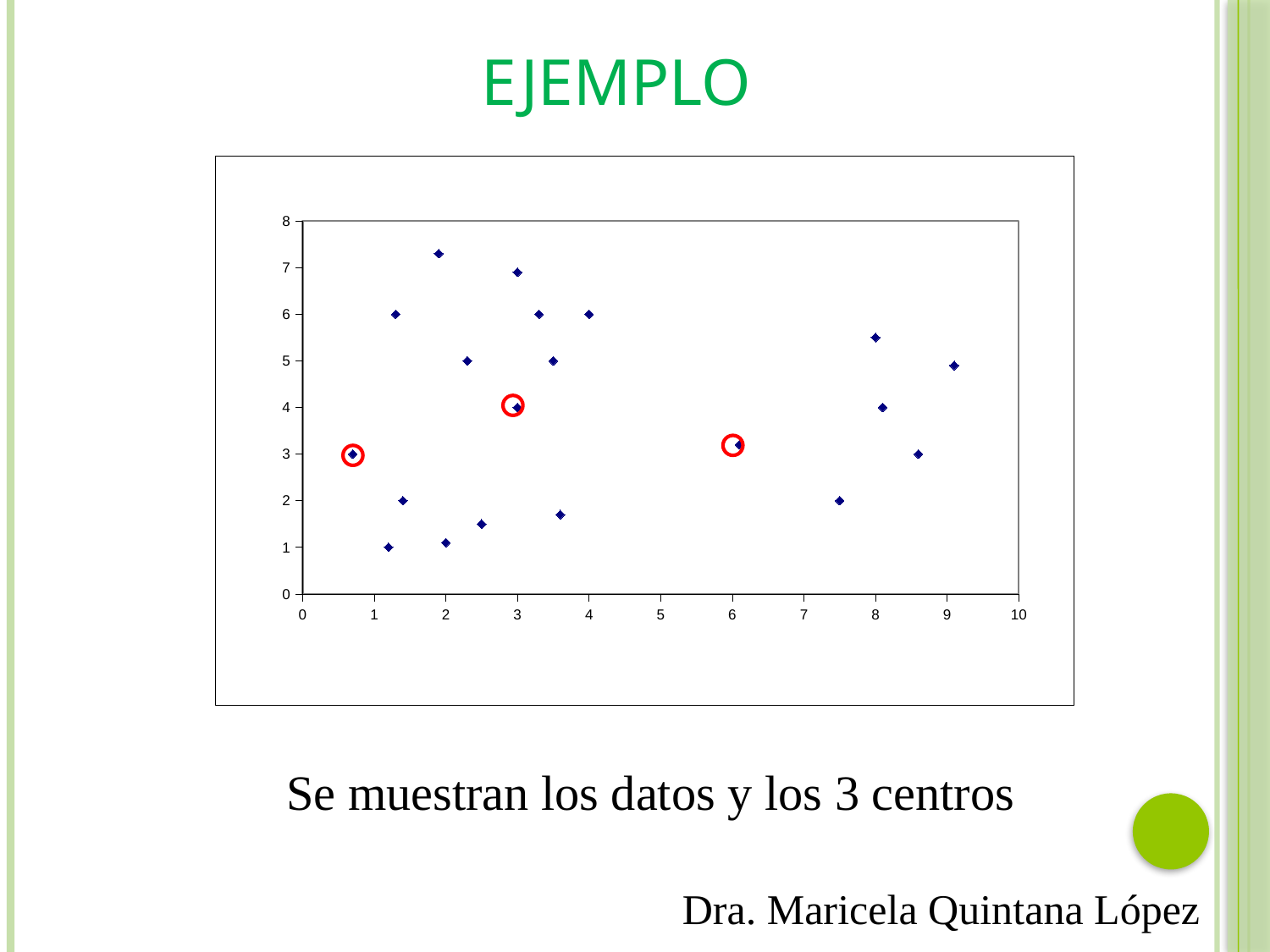
What is the maximum value shown on the x axis of the chart? 10 How many points are marked with red circles on the chart? 3 Which red-circled point has the larger x value: the one near y = 3 on the far left or the one near x = 6? the one near x = 6 How many data points lie to the right of x = 7 on the chart? 5 Is the y value of the lowest point on the chart greater or less than 2? less Is the y value of the highest point on the chart greater or less than 7? greater Is the x value of the rightmost point on the chart greater or less than 8? greater What is the maximum value shown on the y axis of the chart? 8 What is the title of the slide containing the chart? EJEMPLO What kind of chart is shown on the slide? scatter chart